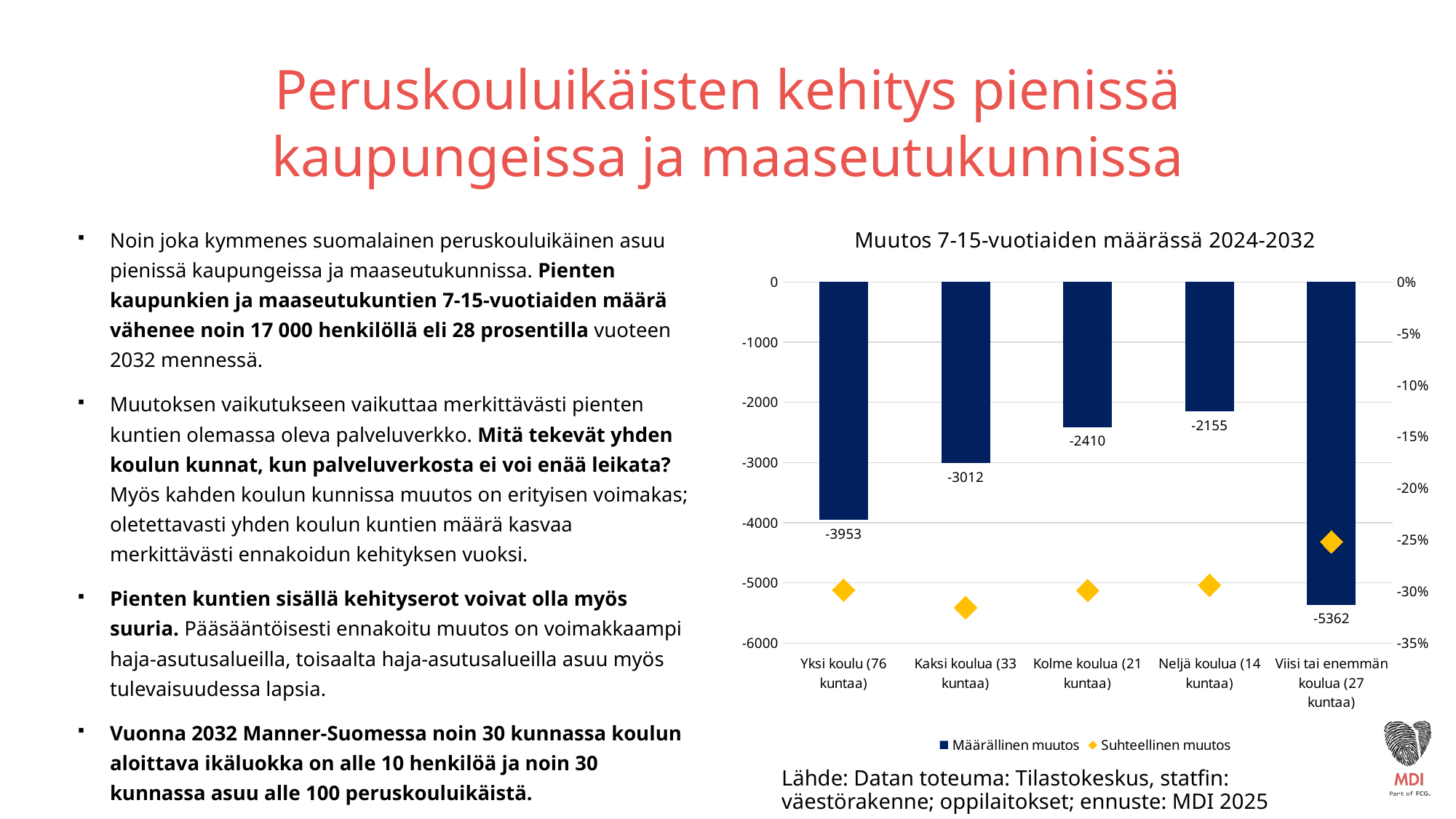
Which category has the smallest decrease (least negative Määrällinen muutos)? Neljä koulua (14 kuntaa) What is the value of Määrällinen muutos for Yksi koulu (76 kuntaa)? -3953 What is the difference between the Määrällinen muutos values for Yksi koulu (76 kuntaa) and Kaksi koulua (33 kuntaa)? 941 Which category has the largest decrease (most negative Määrällinen muutos)? Viisi tai enemmän koulua (27 kuntaa) How many series does the chart legend list? 2 Is the Suhteellinen muutos for Kaksi koulua (33 kuntaa) greater or less than -25%? less Which has the larger decrease in Määrällinen muutos: Kolme koulua (21 kuntaa) or Neljä koulua (14 kuntaa)? Kolme koulua (21 kuntaa) What is the title of the chart? Muutos 7-15-vuotiaiden määrässä 2024-2032 What is the value of Määrällinen muutos for Kaksi koulua (33 kuntaa)? -3012 What is the value of Määrällinen muutos for Viisi tai enemmän koulua (27 kuntaa)? -5362 How many categories are shown on the x axis of the chart? 5 Is the Suhteellinen muutos for Viisi tai enemmän koulua (27 kuntaa) greater or less than -30%? greater